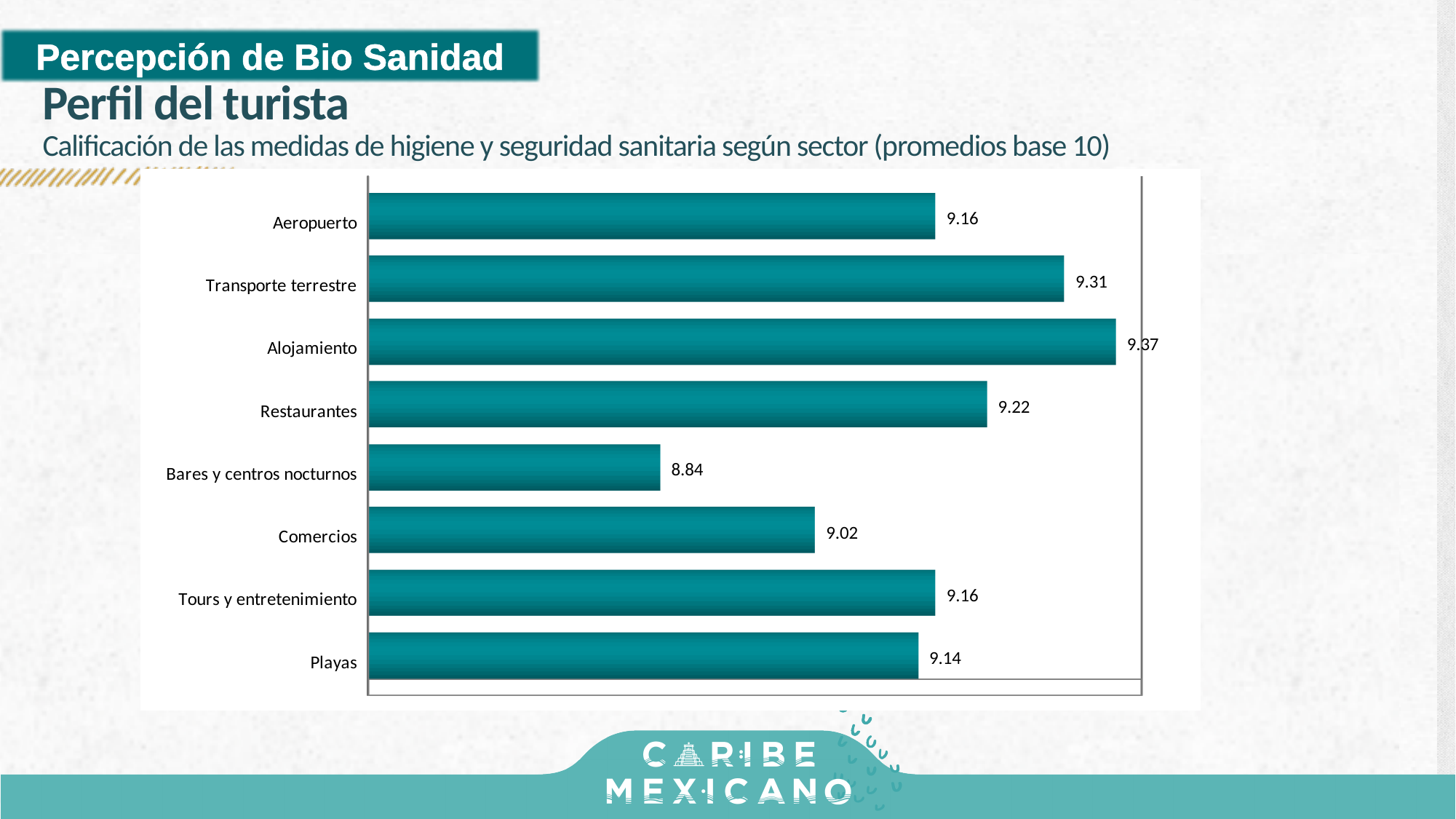
What is the subtitle describing the chart on the slide? Calificación de las medidas de higiene y seguridad sanitaria según sector (promedios base 10) What is the value for Transporte terrestre? 9.31 How many categories are shown in the chart? 8 What is the difference between the values for Alojamiento and Bares y centros nocturnos? 0.53 Which category has the highest value? Alojamiento What is the value for Comercios? 9.02 What is the value for Alojamiento? 9.37 What kind of chart is shown on the slide? Bar chart What is the difference between the values for Transporte terrestre and Restaurantes? 0.09 Which category has the lowest value? Bares y centros nocturnos Which is larger, the value for Restaurantes or the value for Comercios? Restaurantes What is the value for Bares y centros nocturnos? 8.84